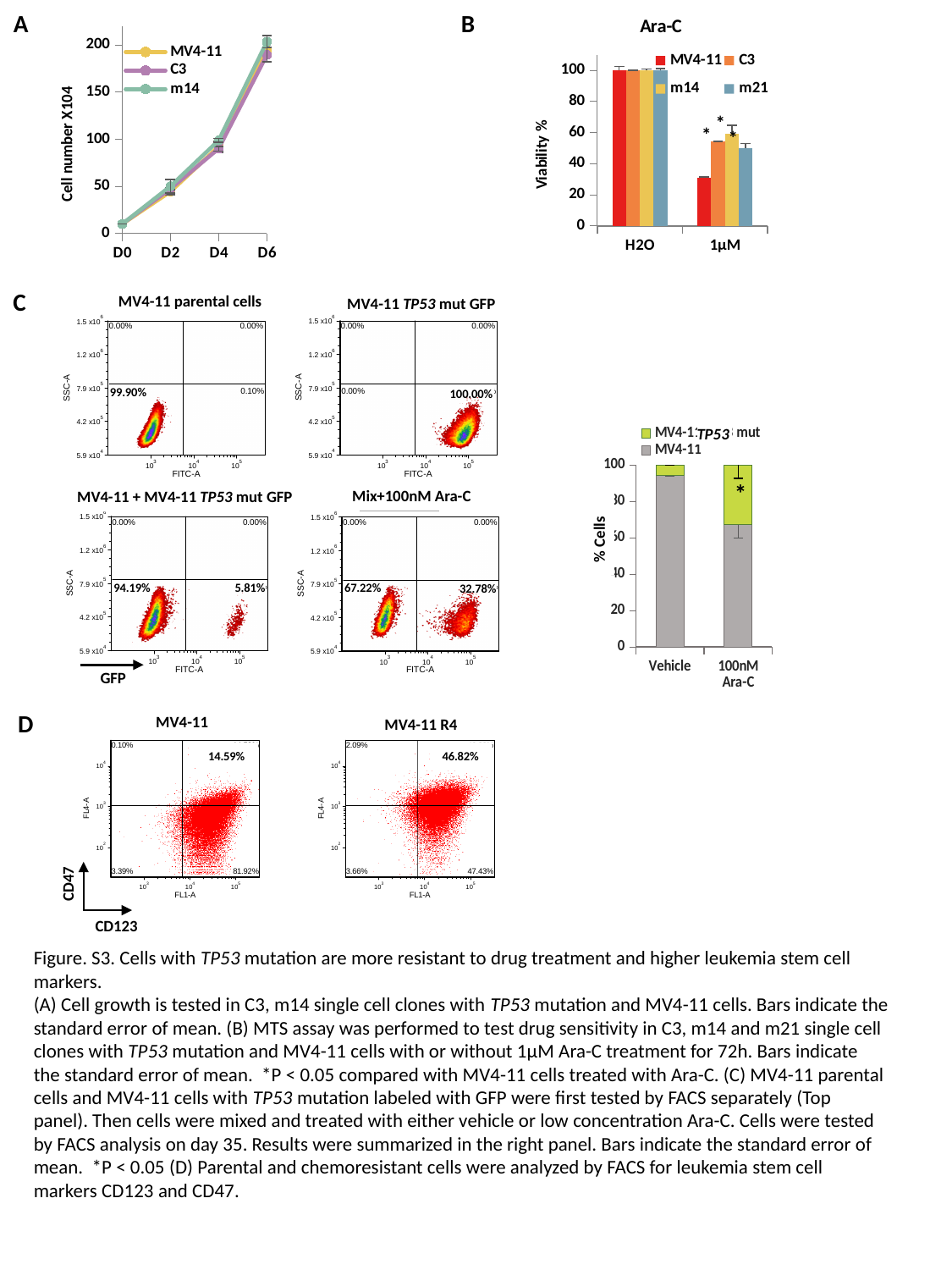
In panel C, what percentage of cells is in the lower-right quadrant of the 'Mix+100nM Ara-C' plot? 32.78% In panel A, is the cell number for MV4-11 at D6 greater or less than 150? greater In panel D, what percentage is shown in the upper-right quadrant of the 'MV4-11 R4' plot? 46.82% In panel B (Ara-C), at 1µM, which has higher viability: MV4-11 or m14? m14 In panel A, how many time points are shown on the x axis? 4 In panel C, what percentage of cells is in the lower-left quadrant of the 'MV4-11 + MV4-11 TP53 mut GFP' plot? 94.19% In panel A, what kind of chart is used to show cell number over time? line chart In panel A, do the cell numbers rise or fall from D0 to D6? rise In panel A, how many cell lines does the legend list? 3 In panel B (Ara-C), is the viability of MV4-11 at 1µM greater or less than 40? less In panel B (Ara-C), how many cell lines does the legend list? 4 In panel B (Ara-C), which cell line has the lowest viability at 1µM? MV4-11